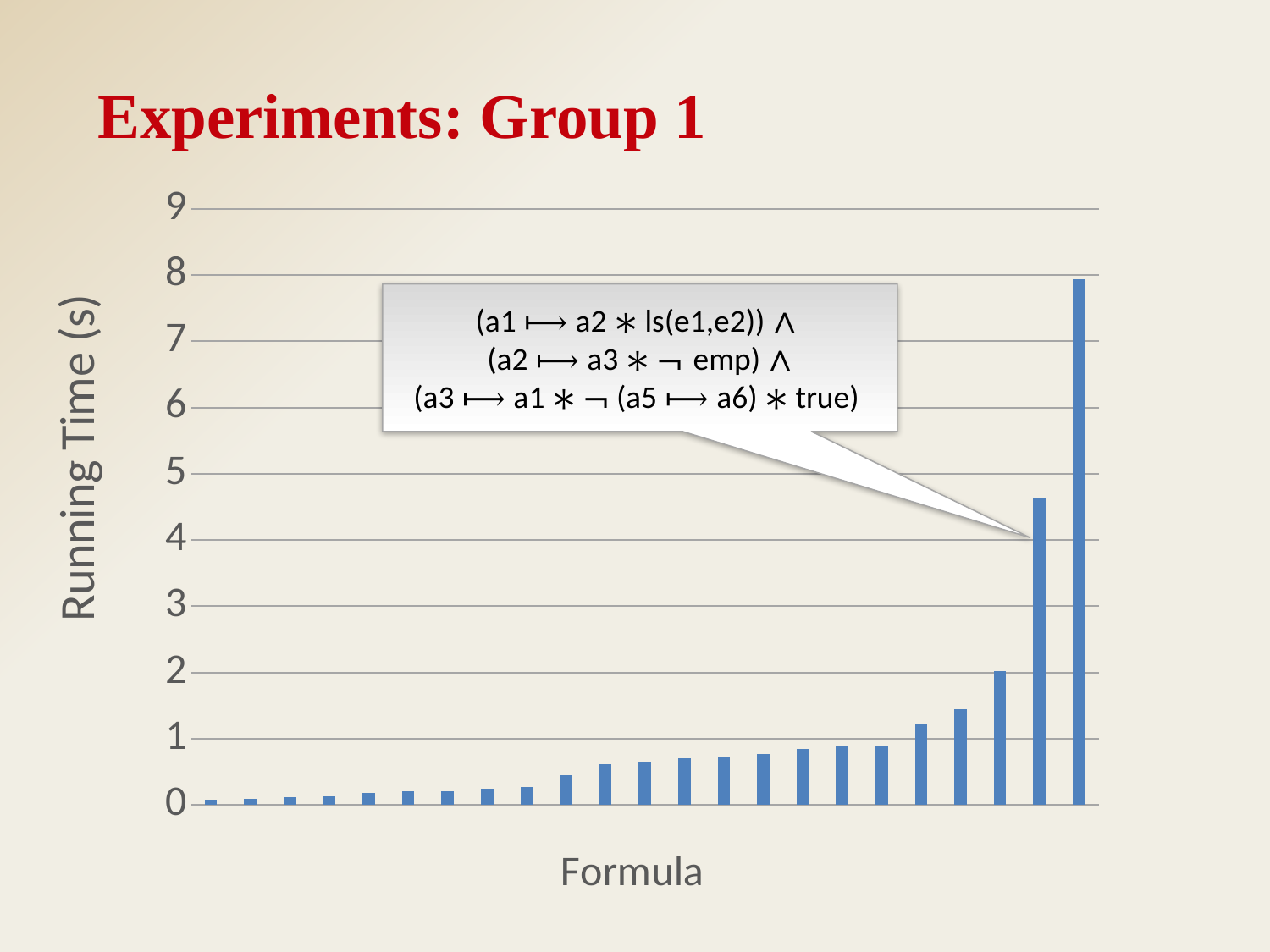
Which bar has the highest running time, the rightmost bar or the second bar from the right? the rightmost bar Is the value of the second bar from the right greater or less than 4? greater What is the label of the horizontal axis? Formula Do the bar values rise or fall from left to right along the x axis? rise How many bars are plotted in the chart? 23 Is the value of the tallest (rightmost) bar greater or less than 7? greater What kind of chart is shown on the slide? bar chart Is the value of the leftmost bar greater or less than 1? less What is the label of the vertical axis? Running Time (s)